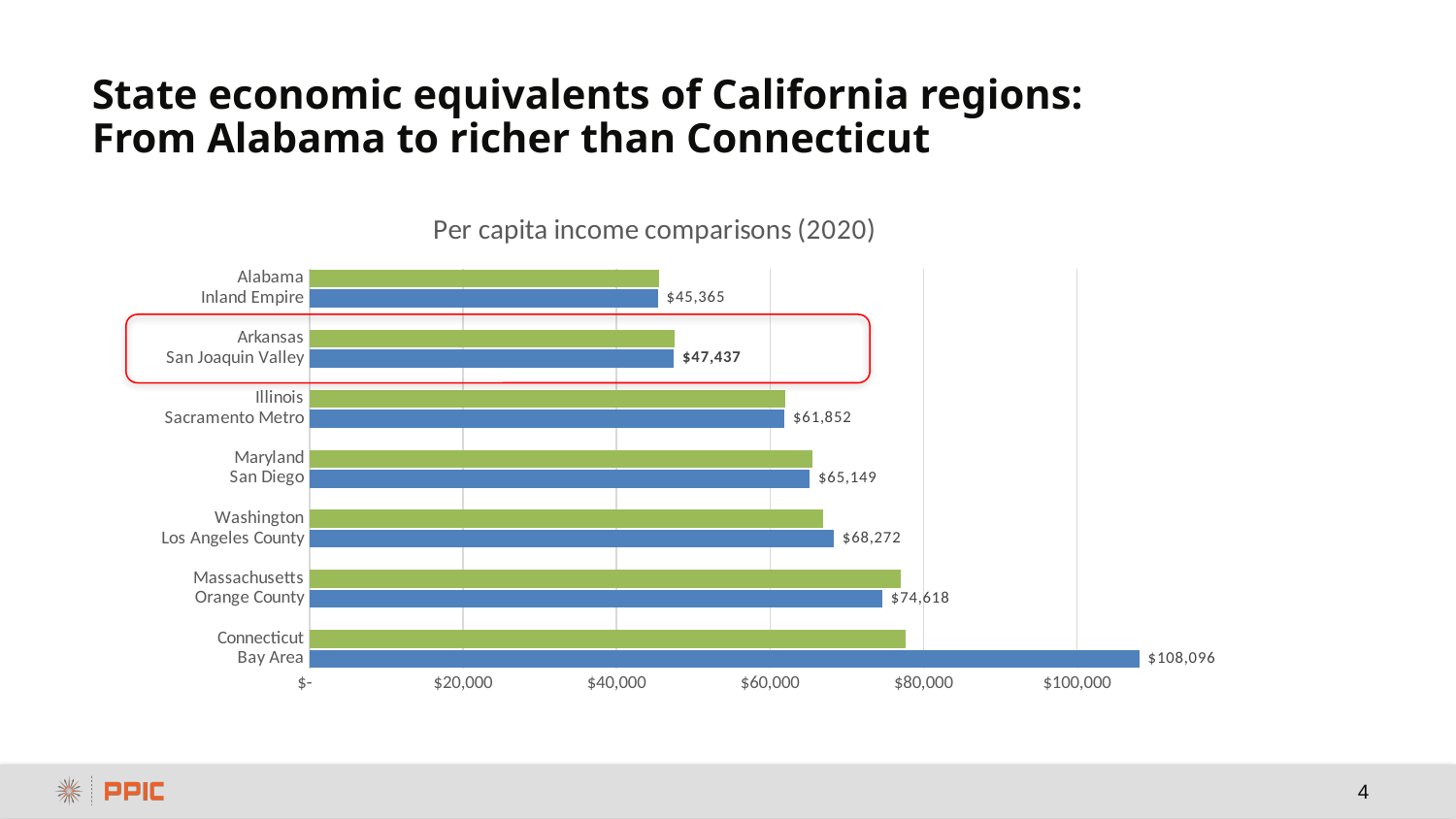
What is the title of the chart? Per capita income comparisons (2020) Which has a higher per capita income, Sacramento Metro or San Diego? San Diego How many California regions are shown on the chart? 7 What is the per capita income shown for the San Joaquin Valley? $47,437 What is the per capita income shown for the Bay Area? $108,096 Is the value for Connecticut greater or less than $60,000? greater What kind of chart is shown on the slide? Bar chart Which California region has the lowest per capita income on the chart? Inland Empire What is the per capita income shown for the Inland Empire? $45,365 What is the difference between the per capita income of the Bay Area and Orange County? $33,478 Which California region has the highest per capita income on the chart? Bay Area What is the per capita income shown for Orange County? $74,618